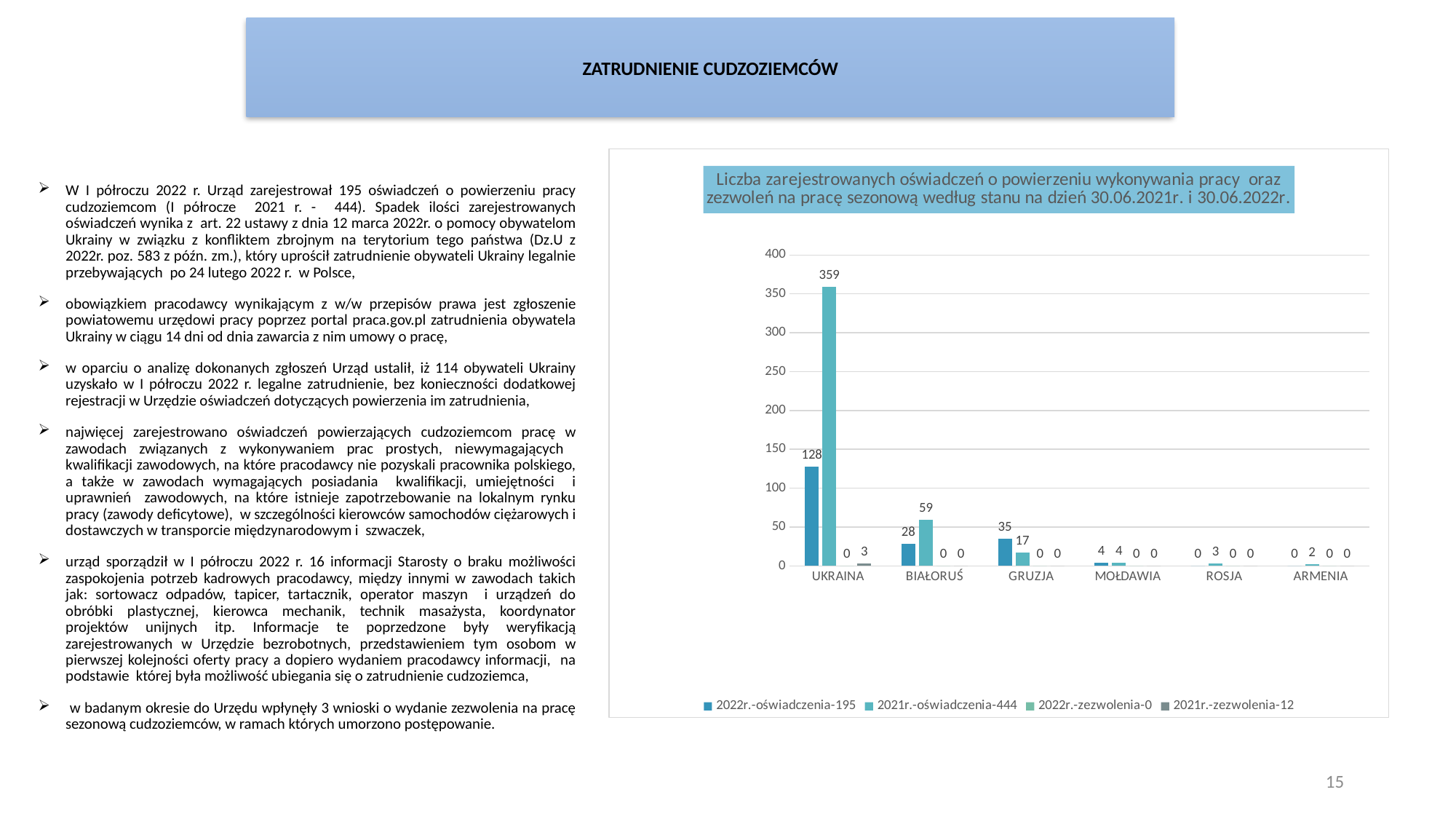
What is the value for UKRAINA in the series 2022r.-oświadczenia-195? 128 What is the value for ROSJA in the series 2021r.-oświadczenia-444? 3 What is the value for GRUZJA in the series 2022r.-oświadczenia-195? 35 What type of chart is shown on the slide? bar chart What is the difference between the 2021r.-oświadczenia-444 value and the 2022r.-oświadczenia-195 value for UKRAINA? 231 What is the value for BIAŁORUŚ in the series 2021r.-oświadczenia-444? 59 What is the value for UKRAINA in the series 2021r.-zezwolenia-12? 3 How many countries are shown on the x axis of the chart? 6 For GRUZJA, which is larger: the 2022r.-oświadczenia-195 value or the 2021r.-oświadczenia-444 value? 2022r.-oświadczenia-195 Which country has the highest value in the series 2021r.-oświadczenia-444? UKRAINA How many series does the chart legend list? 4 What is the value for UKRAINA in the series 2021r.-oświadczenia-444? 359